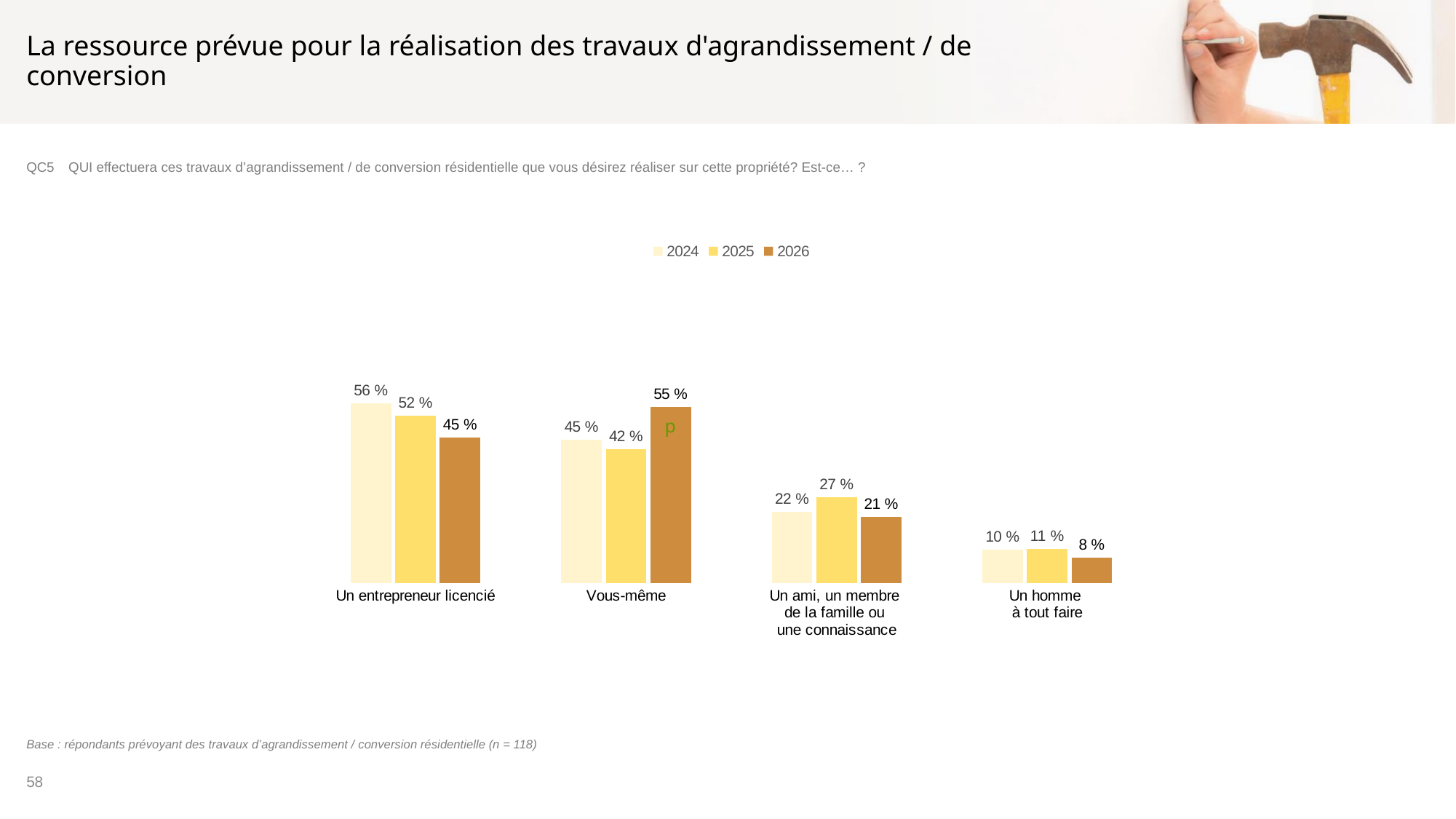
What is the difference between the 2024 and 2026 values for 'Un entrepreneur licencié'? 11 % What is the value for 'Un homme à tout faire' in 2025? 11 % Which category has the highest value in 2026? Vous-même Which is larger for 'Un ami, un membre de la famille ou une connaissance': the 2025 value or the 2024 value? 2025 Which category has the lowest value in 2024? Un homme à tout faire How many series does the legend list? 3 What kind of chart is shown on the slide? Bar chart What is the value for 'Vous-même' in 2026? 55 % How many categories are shown on the x axis? 4 What is the value for 'Un entrepreneur licencié' in 2024? 56 % What is the value for 'Un ami, un membre de la famille ou une connaissance' in 2026? 21 %